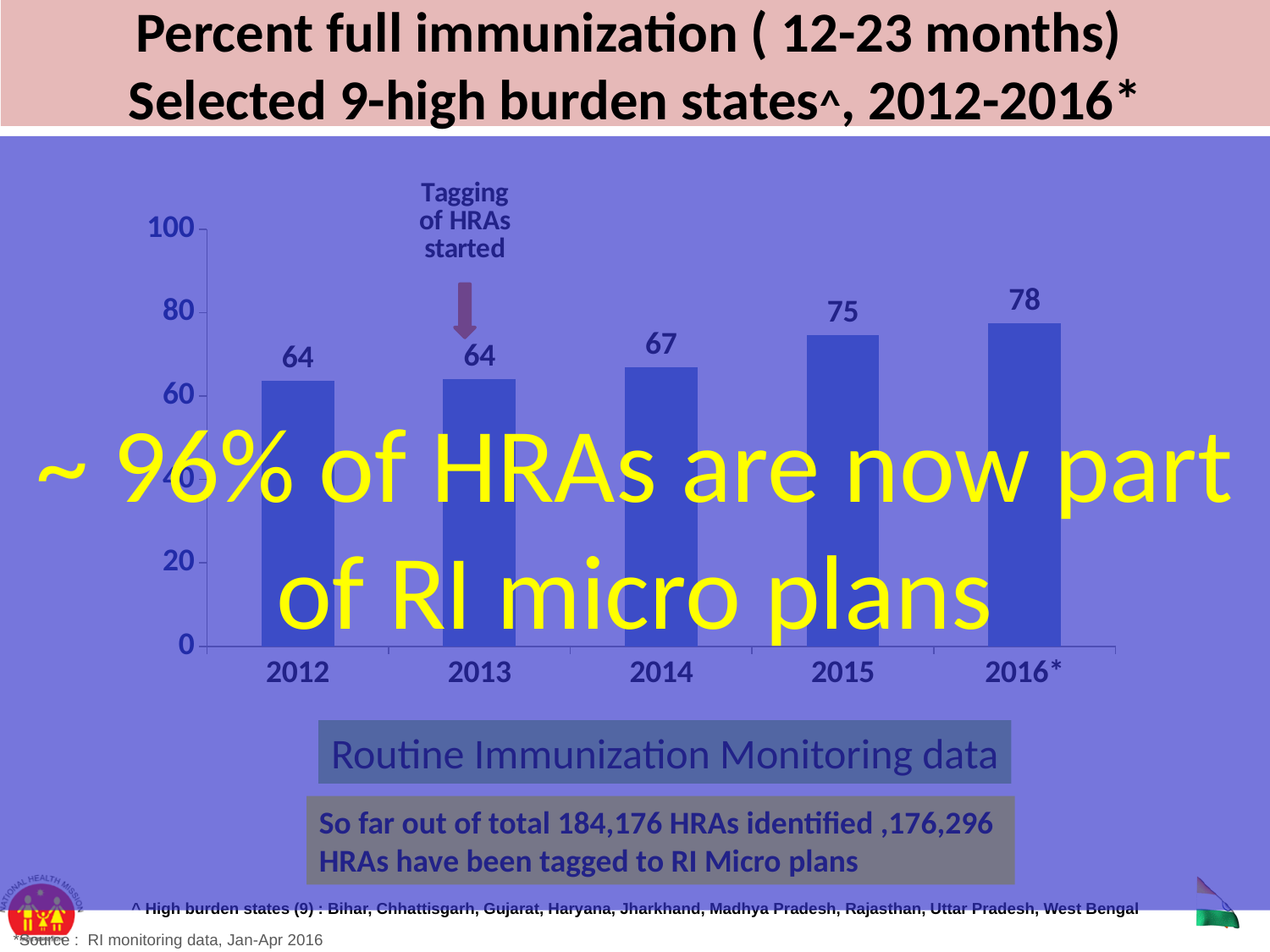
What kind of chart is shown on the slide? bar chart What is the percent full immunization value shown for 2014? 67 Is the value for 2015 greater or less than 60? greater What is the value shown for 2012? 64 Do the values generally rise or fall from 2012 to 2016*? rise Which year has the highest percent full immunization? 2016* What event does the annotation above the 2013 bar indicate? Tagging of HRAs started What is the value shown for 2016*? 78 How many years are shown on the x axis of the chart? 5 What is the difference between the values for 2016* and 2012? 14 What is the difference between the values for 2015 and 2014? 8 Which is larger, the value for 2015 or the value for 2013? 2015